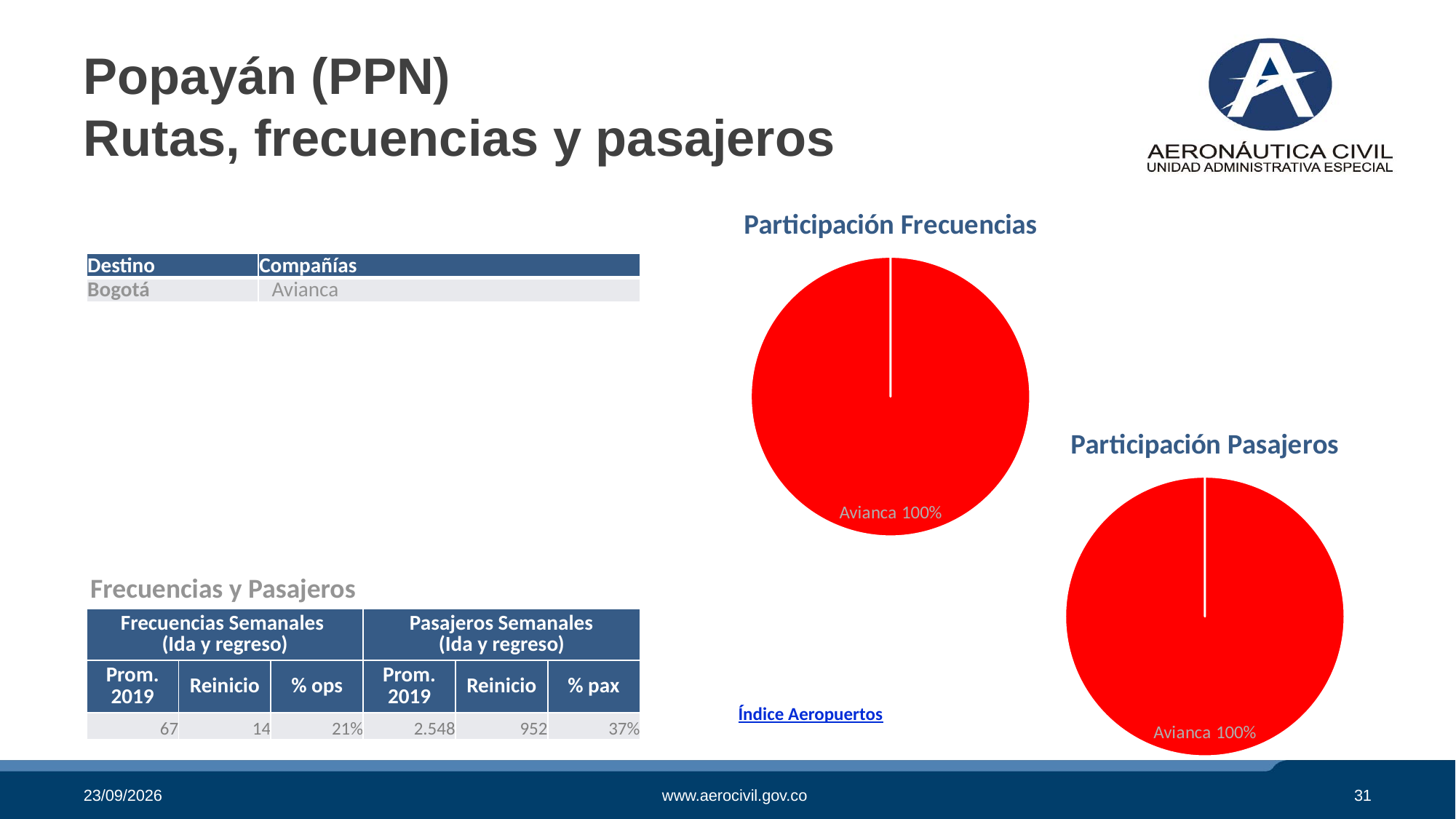
What colour is the Avianca slice in the 'Participación Pasajeros' chart? Red How many slices does the 'Participación Pasajeros' pie chart have? 1 How many slices does the 'Participación Frecuencias' pie chart have? 1 Which company is the only one shown in the 'Participación Frecuencias' chart? Avianca What is the title of the pie chart in the upper right of the slide? Participación Frecuencias What kind of chart is 'Participación Pasajeros'? Pie chart What kind of chart is 'Participación Frecuencias'? Pie chart Which company is the only one shown in the 'Participación Pasajeros' chart? Avianca In the 'Participación Pasajeros' chart, what share does Avianca have? 100% In the 'Participación Frecuencias' chart, what share does Avianca have? 100%